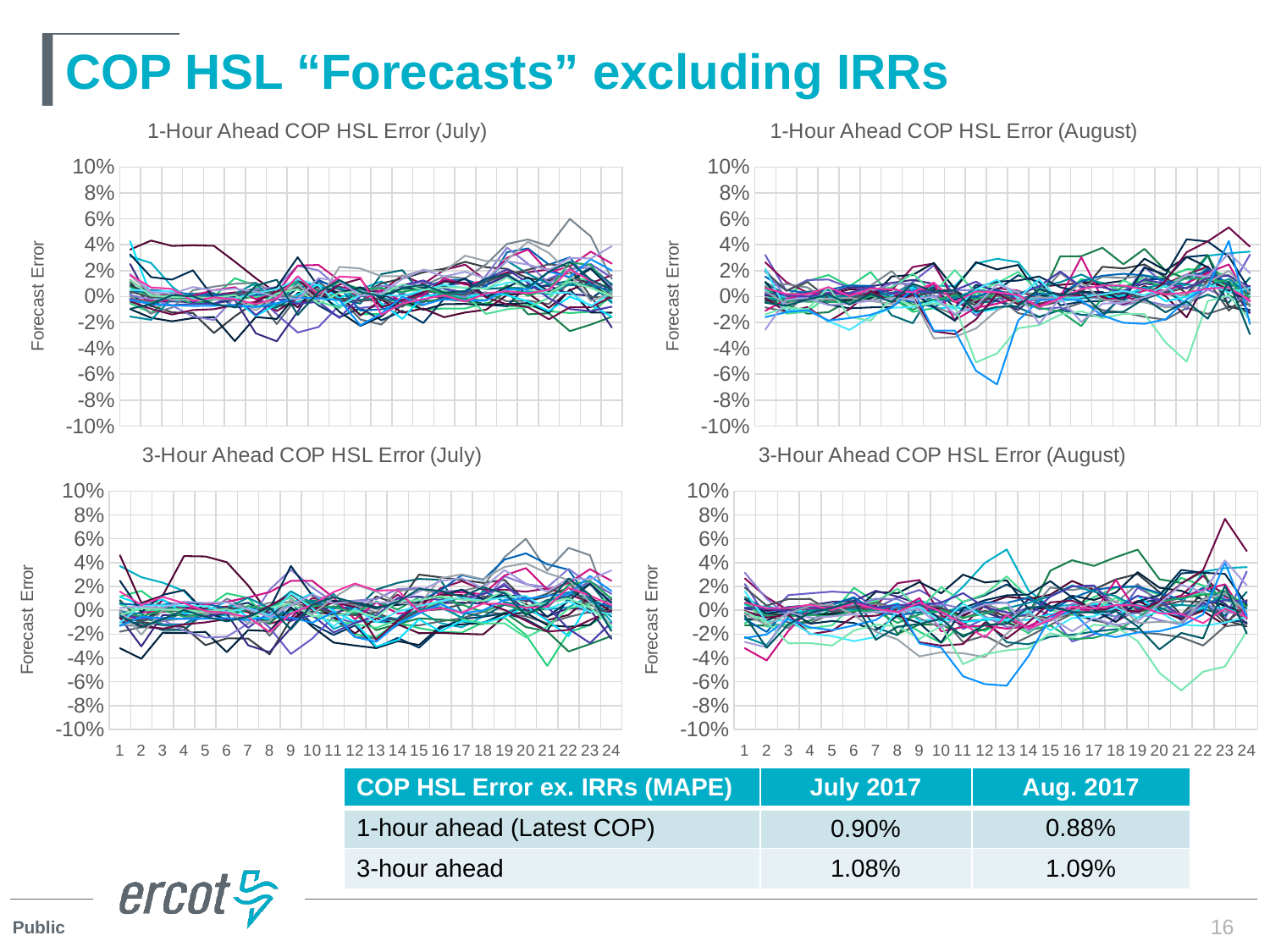
What is the title of the chart in the bottom-left position of the slide? 3-Hour Ahead COP HSL Error (July) In the '3-Hour Ahead COP HSL Error (July)' chart, is the lowest value reached by any line greater or less than -2%? less What is the y-axis label on the '1-Hour Ahead COP HSL Error (August)' chart? Forecast Error In the '3-Hour Ahead COP HSL Error (August)' chart, is the highest value reached by any line greater or less than 6%? greater What is the maximum value shown on the y axis of the '3-Hour Ahead COP HSL Error (July)' chart? 10% How many hourly points are shown along the x axis of the '3-Hour Ahead COP HSL Error (August)' chart? 24 In the '1-Hour Ahead COP HSL Error (July)' chart, is the highest value reached by any line greater or less than 4%? greater Which chart reaches a higher peak value: '1-Hour Ahead COP HSL Error (July)' or '3-Hour Ahead COP HSL Error (August)'? 3-Hour Ahead COP HSL Error (August) What kind of chart is the '1-Hour Ahead COP HSL Error (July)' chart? line chart How many charts are shown on the slide? 4